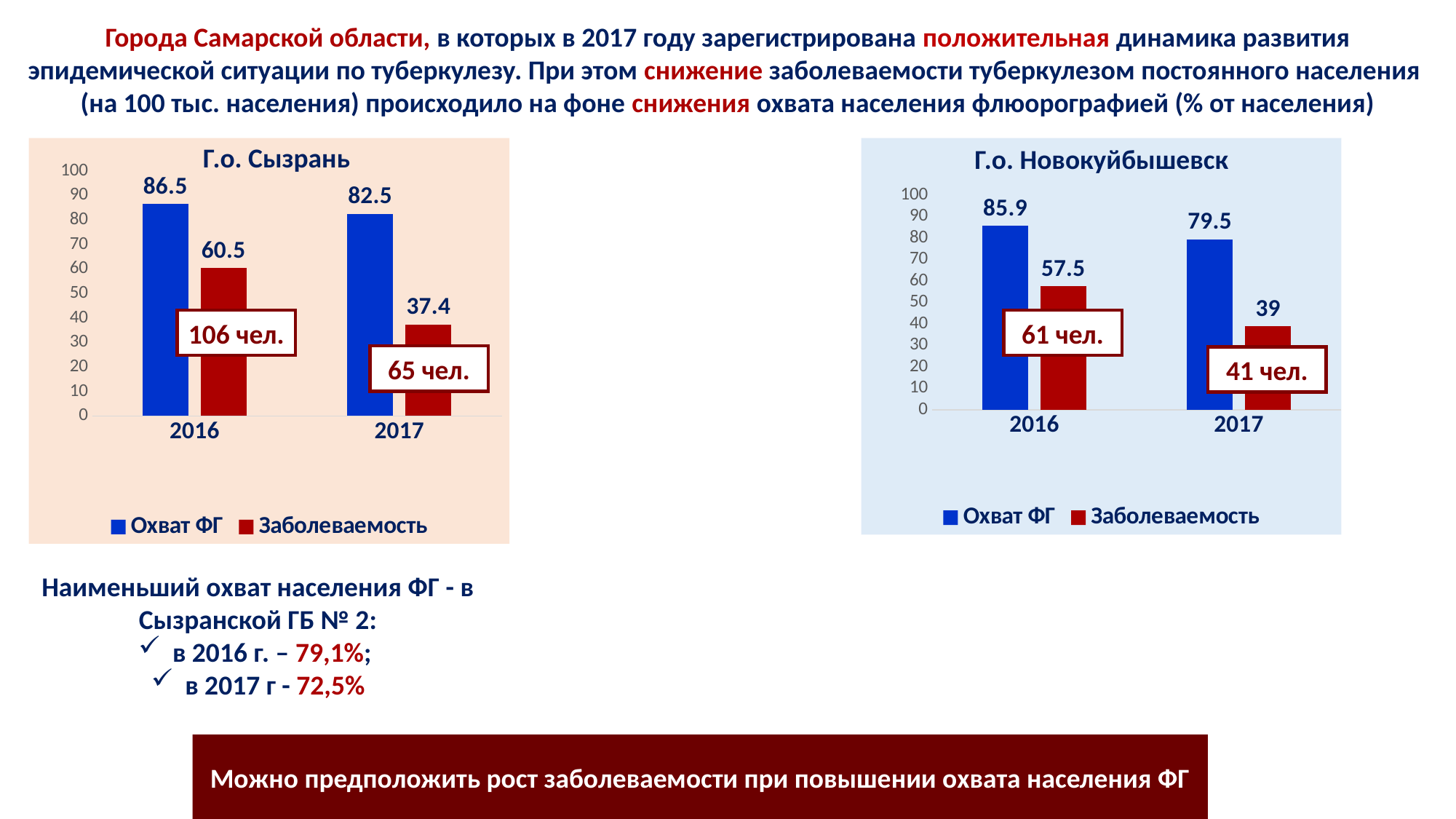
In the chart titled "Г.о. Новокуйбышевск", what is the difference between Охват ФГ in 2016 and in 2017? 6.4 In the chart titled "Г.о. Сызрань", by how much did Заболеваемость decrease from 2016 to 2017? 23.1 In the chart titled "Г.о. Сызрань", which year has the higher value of Охват ФГ, 2016 or 2017? 2016 In the chart titled "Г.о. Новокуйбышевск", what is the value of Охват ФГ for 2017? 79.5 How many series does the legend of the chart titled "Г.о. Сызрань" list? 2 In the chart titled "Г.о. Сызрань", what is the value of Заболеваемость for 2017? 37.4 In the chart titled "Г.о. Новокуйбышевск", what is the value of Заболеваемость for 2016? 57.5 In the chart titled "Г.о. Новокуйбышевск", does Заболеваемость rise or fall from 2016 to 2017? fall How many year categories are shown on the x axis of the chart titled "Г.о. Новокуйбышевск"? 2 In the chart titled "Г.о. Сызрань", which colour represents the series Заболеваемость? red In the chart titled "Г.о. Сызрань", what is the value of Охват ФГ for 2016? 86.5 What type of chart is the chart titled "Г.о. Новокуйбышевск"? bar chart